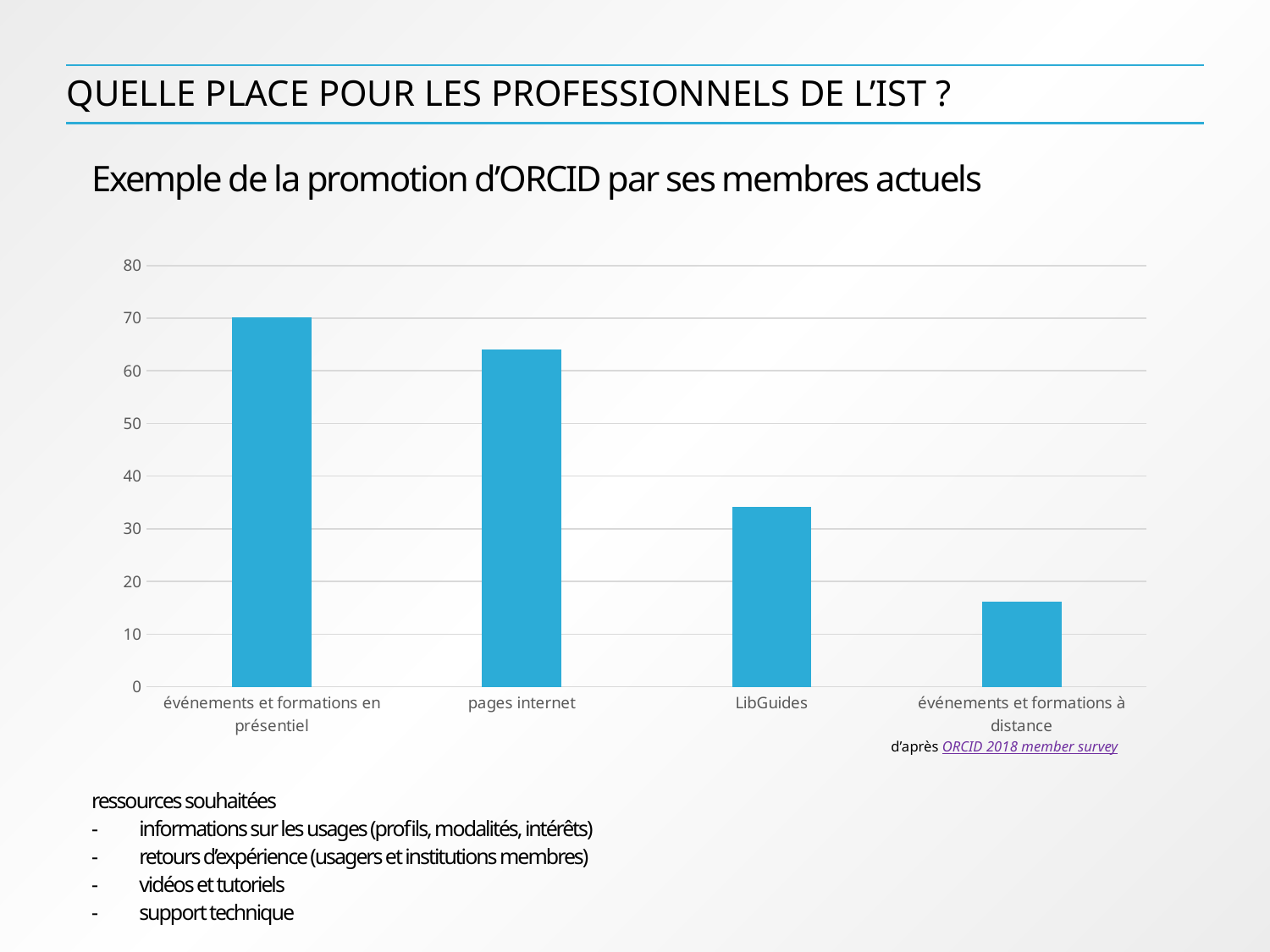
How many categories are shown on the x axis of the chart? 4 What kind of chart is shown on the slide? bar chart Is the value for événements et formations à distance greater or less than 20? less Do the bar values rise or fall from left to right along the x axis? fall Which is larger, the value for pages internet or the value for LibGuides? pages internet Is the value for événements et formations en présentiel greater or less than 60? greater Which category has the highest bar in the chart? événements et formations en présentiel Which category has the lowest bar in the chart? événements et formations à distance Is the value for LibGuides greater or less than 30? greater According to the note under the chart, what source is the data taken from? ORCID 2018 member survey